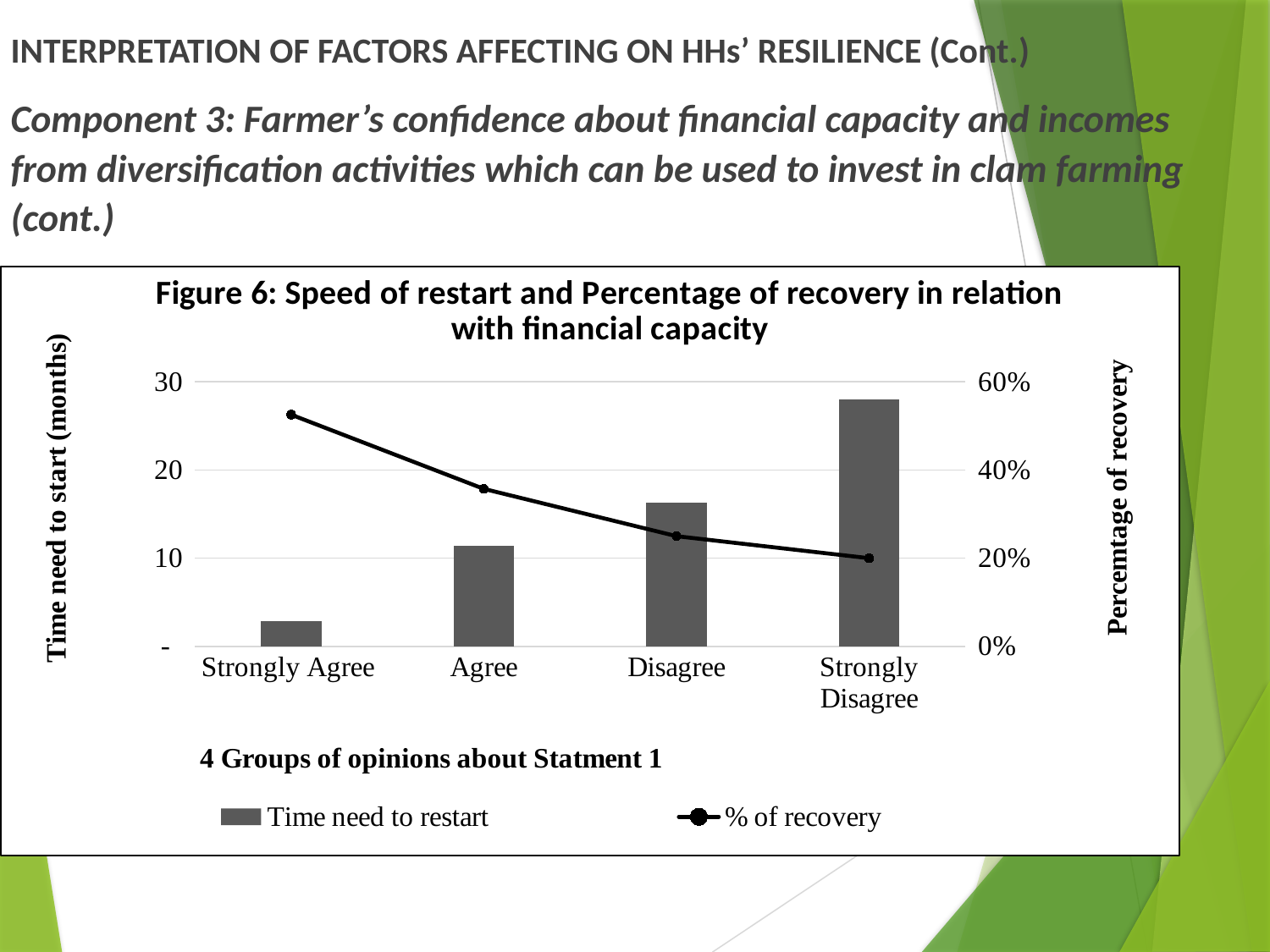
Is the Time need to restart for Strongly Disagree greater or less than 20 months? greater Which opinion group has the highest % of recovery? Strongly Agree Which opinion group has the lowest value for Time need to restart? Strongly Agree Does the % of recovery rise or fall from Strongly Agree to Strongly Disagree? fall Is the % of recovery for Strongly Agree greater or less than 40%? greater How many opinion groups are shown on the x axis? 4 Which has a longer Time need to restart, Agree or Disagree? Disagree Which opinion group has the highest value for Time need to restart? Strongly Disagree Is the % of recovery for Strongly Disagree greater or less than 40%? less How many series does the legend list? 2 Which opinion group has the lowest % of recovery? Strongly Disagree